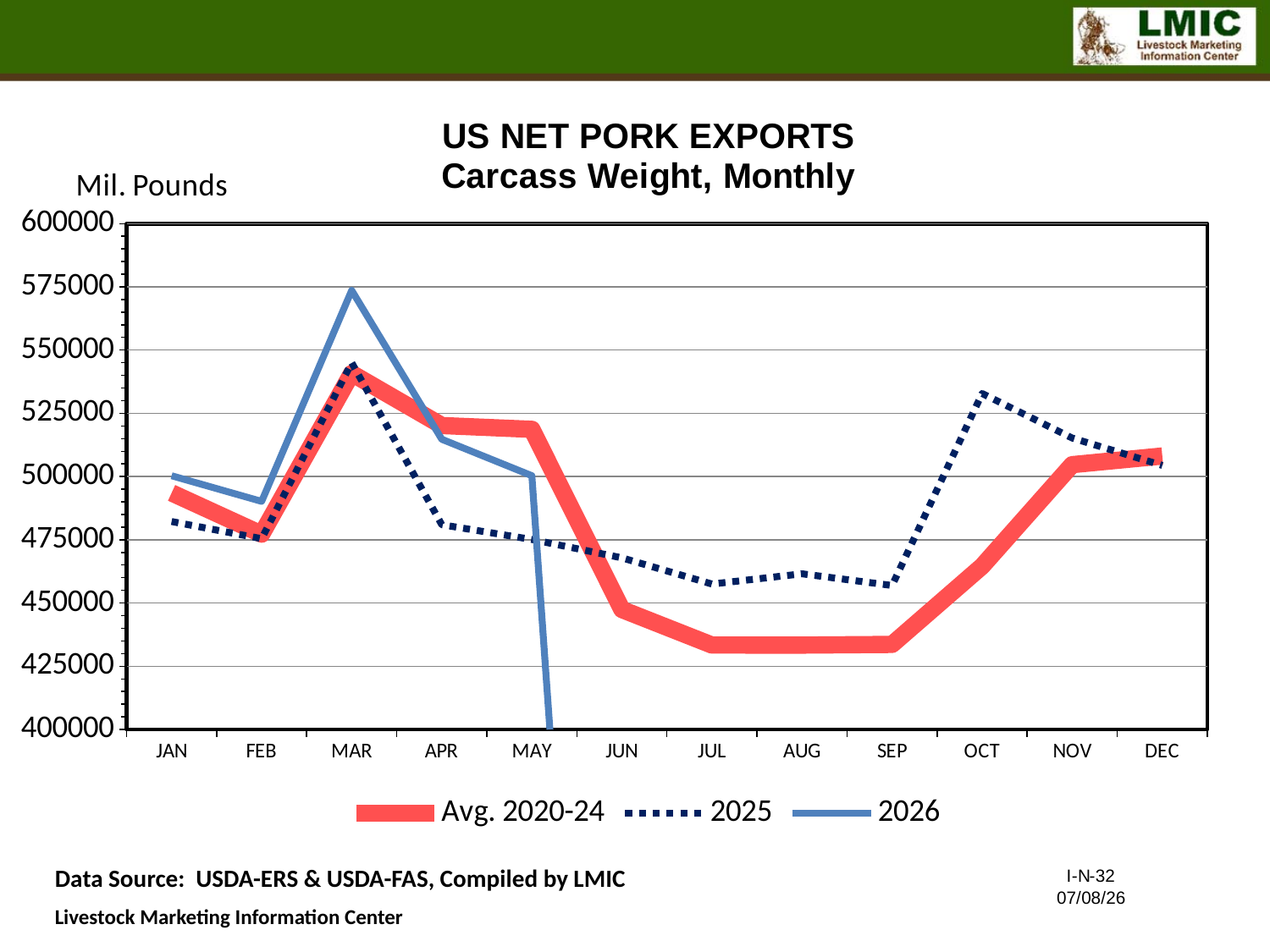
Is the 2026 value for MAR greater or less than 550000? greater How many months are shown along the x axis? 12 In OCT, which series has the larger value, 2025 or Avg. 2020-24? 2025 Is the 2025 value for JUL greater or less than 475000? less What unit label is shown above the y axis? Mil. Pounds In APR, which series has the larger value, Avg. 2020-24 or 2025? Avg. 2020-24 Is the Avg. 2020-24 value for AUG greater or less than 450000? less In which month does the 2026 series reach its highest value? MAR How many series does the legend list? 3 In which month does the 2025 series reach its highest value? MAR In which month does the Avg. 2020-24 series reach its highest value? MAR What kind of chart is shown on the slide? line chart